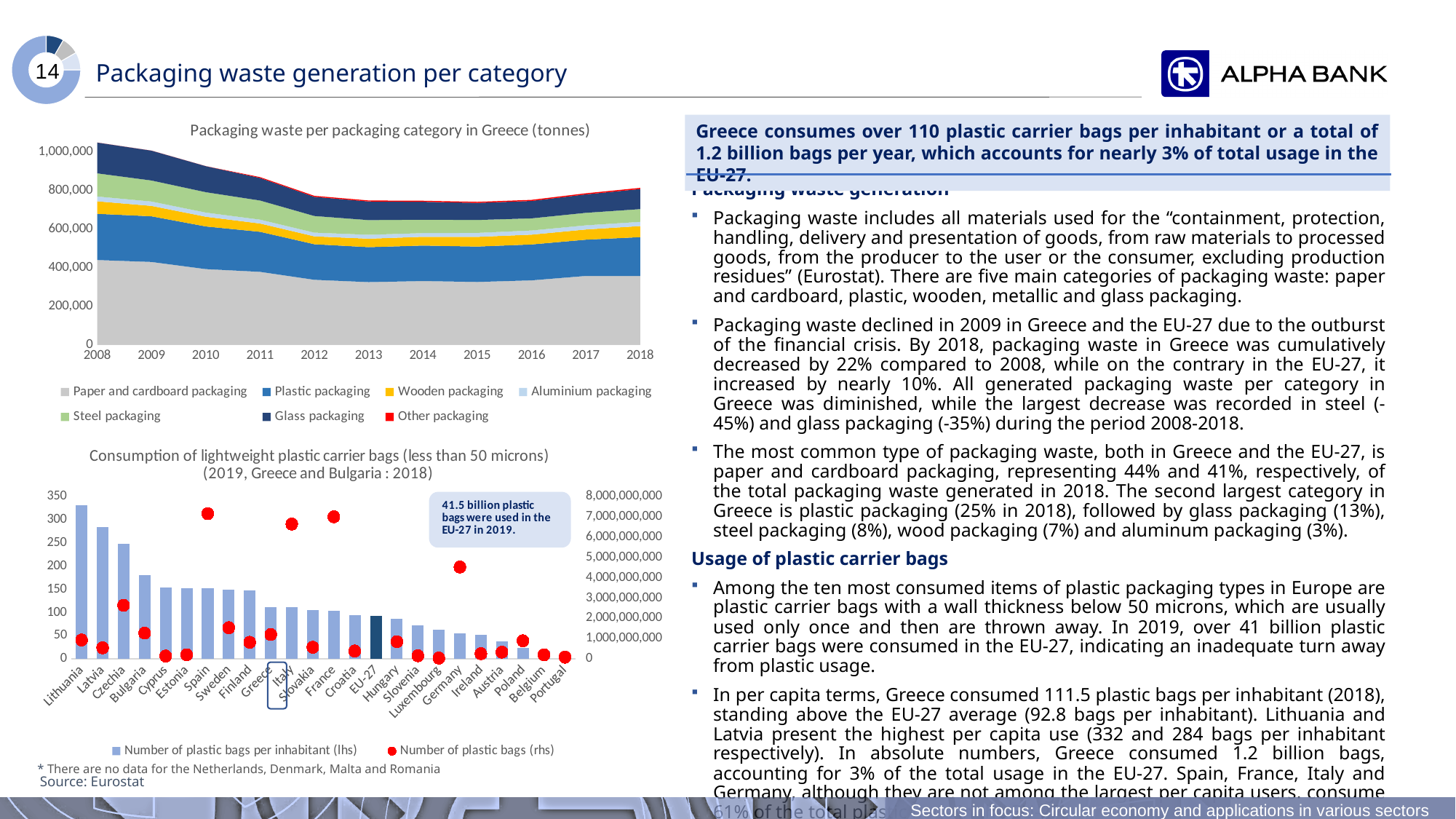
In the top chart on packaging waste in Greece, is the total packaging waste in 2018 greater or less than 1,000,000 tonnes? less In the bottom chart on consumption of lightweight plastic carrier bags, which has more plastic bags per inhabitant, Lithuania or Latvia? Lithuania In the top chart on packaging waste in Greece, is the paper and cardboard packaging value in 2008 greater or less than 400,000 tonnes? greater In the top chart on packaging waste in Greece, how many years are shown on the x axis? 11 What type of chart is the top chart, 'Packaging waste per packaging category in Greece (tonnes)'? Stacked area chart In the bottom chart on consumption of lightweight plastic carrier bags, how many plastic bags does the annotation say were used in the EU-27 in 2019? 41.5 billion In the bottom chart on consumption of lightweight plastic carrier bags, which country has the highest number of plastic bags per inhabitant? Lithuania In the bottom chart on consumption of lightweight plastic carrier bags, which country has the lowest number of plastic bags per inhabitant? Portugal In the bottom chart on consumption of lightweight plastic carrier bags, is the number of plastic bags per inhabitant for Greece greater or less than 100? greater In the bottom chart on consumption of lightweight plastic carrier bags, how many countries/regions are shown on the x axis? 24 In the top chart on packaging waste in Greece, does total packaging waste rise or fall between 2008 and 2013? Fall In the top chart on packaging waste in Greece, how many packaging categories does the legend list? 7